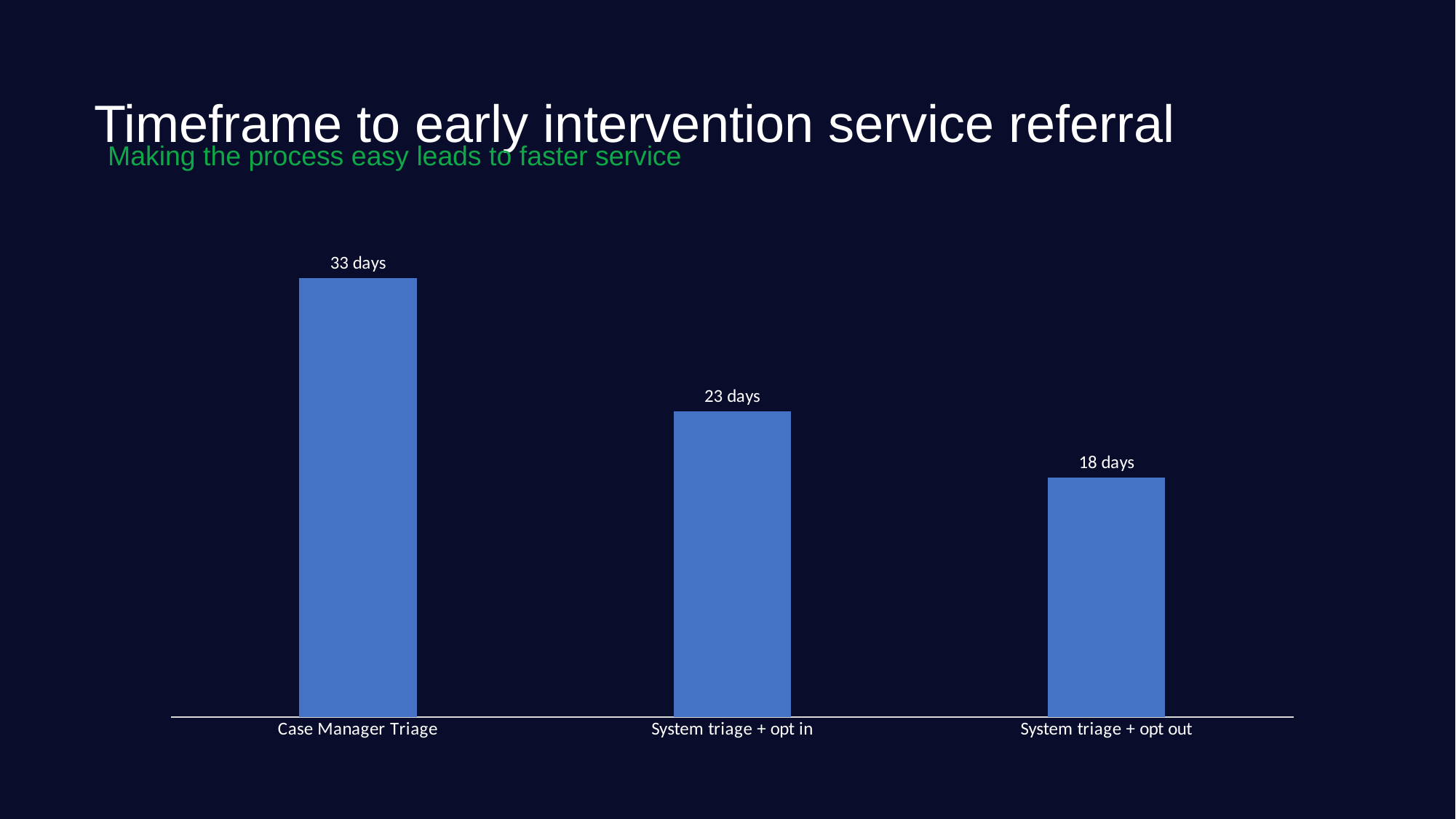
What is the difference between Case Manager Triage and System triage + opt out? 15 days Which category has the highest value? Case Manager Triage Which category has the lowest value? System triage + opt out What is the difference between Case Manager Triage and System triage + opt in? 10 days Which is larger, System triage + opt in or System triage + opt out? System triage + opt in Do the values rise or fall from left to right across the categories? Fall How many categories are shown in the chart? 3 What is the value for System triage + opt in? 23 days What is the value for System triage + opt out? 18 days What is the value for Case Manager Triage? 33 days What is the title of the slide containing the chart? Timeframe to early intervention service referral What kind of chart is shown on the slide? Bar chart